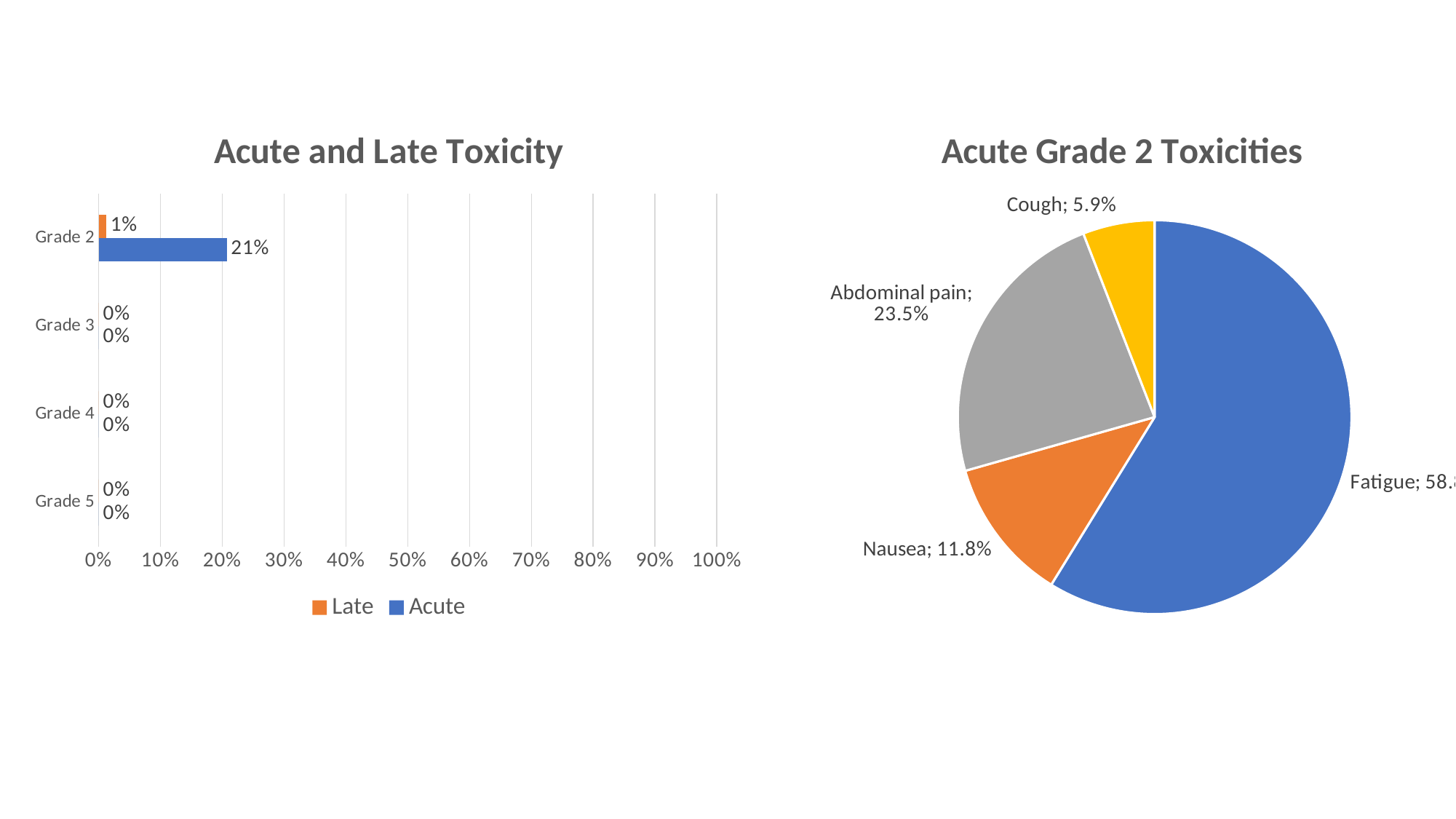
What kind of chart is 'Acute and Late Toxicity'? Bar chart In the 'Acute Grade 2 Toxicities' chart, which toxicity has the smallest slice? Cough In the 'Acute and Late Toxicity' chart, how many grade categories are shown? 4 In the 'Acute and Late Toxicity' chart, what is the Acute value for Grade 2? 21% In the 'Acute and Late Toxicity' chart, what is the difference between the Acute and Late values for Grade 2? 20% In the 'Acute and Late Toxicity' chart, how many series does the legend list? 2 In the 'Acute and Late Toxicity' chart, which grade has the highest Acute value? Grade 2 In the 'Acute Grade 2 Toxicities' chart, what is the value for Nausea? 11.8% In the 'Acute and Late Toxicity' chart, what is the Late value for Grade 2? 1% In the 'Acute Grade 2 Toxicities' chart, which is larger, Abdominal pain or Nausea? Abdominal pain In the 'Acute Grade 2 Toxicities' chart, what is the value for Abdominal pain? 23.5% In the 'Acute and Late Toxicity' chart, what is the Acute value for Grade 3? 0%